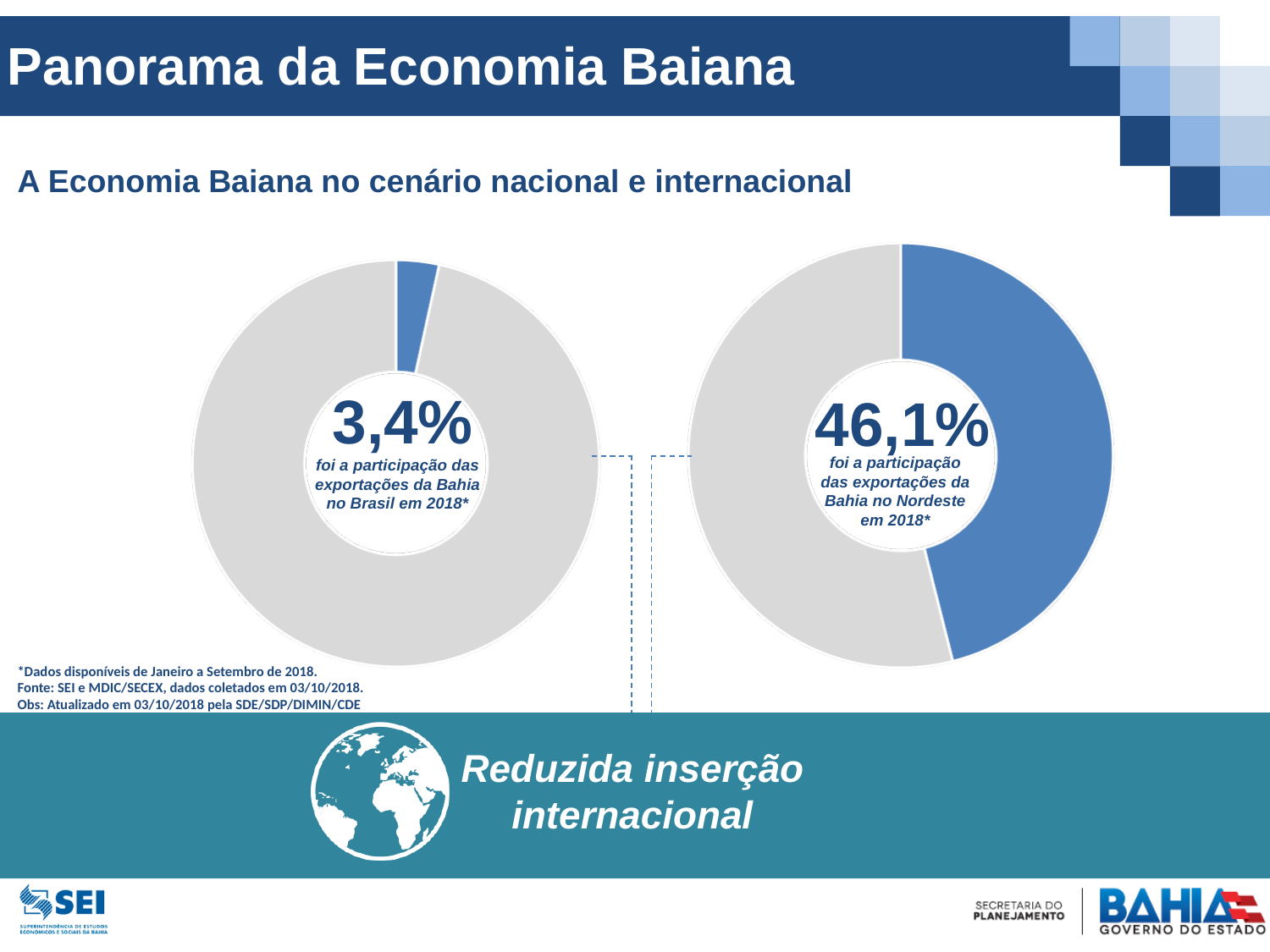
On the left donut chart, what was Bahia's share of Brazil's exports in 2018? 3,4% On the left donut chart, what share of the ring is not highlighted in blue (the grey remainder)? 96,6% How many slices does the left donut chart have? 2 What is the difference in percentage points between the right chart's value (46,1%) and the left chart's value (3,4%)? 42,7 What kind of chart is used on the right side of the slide to show the 46,1% figure? Donut (pie) chart What kind of chart is used on the left side of the slide to show the 3,4% figure? Donut (pie) chart What year do both donut charts refer to, according to the text inside them? 2018 On the right donut chart, what was Bahia's share of the Northeast's exports in 2018? 46,1% What colour is used for the highlighted slice representing Bahia's share in both donut charts? Blue How many slices does the right donut chart have? 2 Which is larger: Bahia's share of exports in Brazil (left chart) or in the Northeast (right chart)? Northeast (right chart) On the right donut chart, what share of the ring is grey (the remainder not attributed to Bahia)? 53,9%